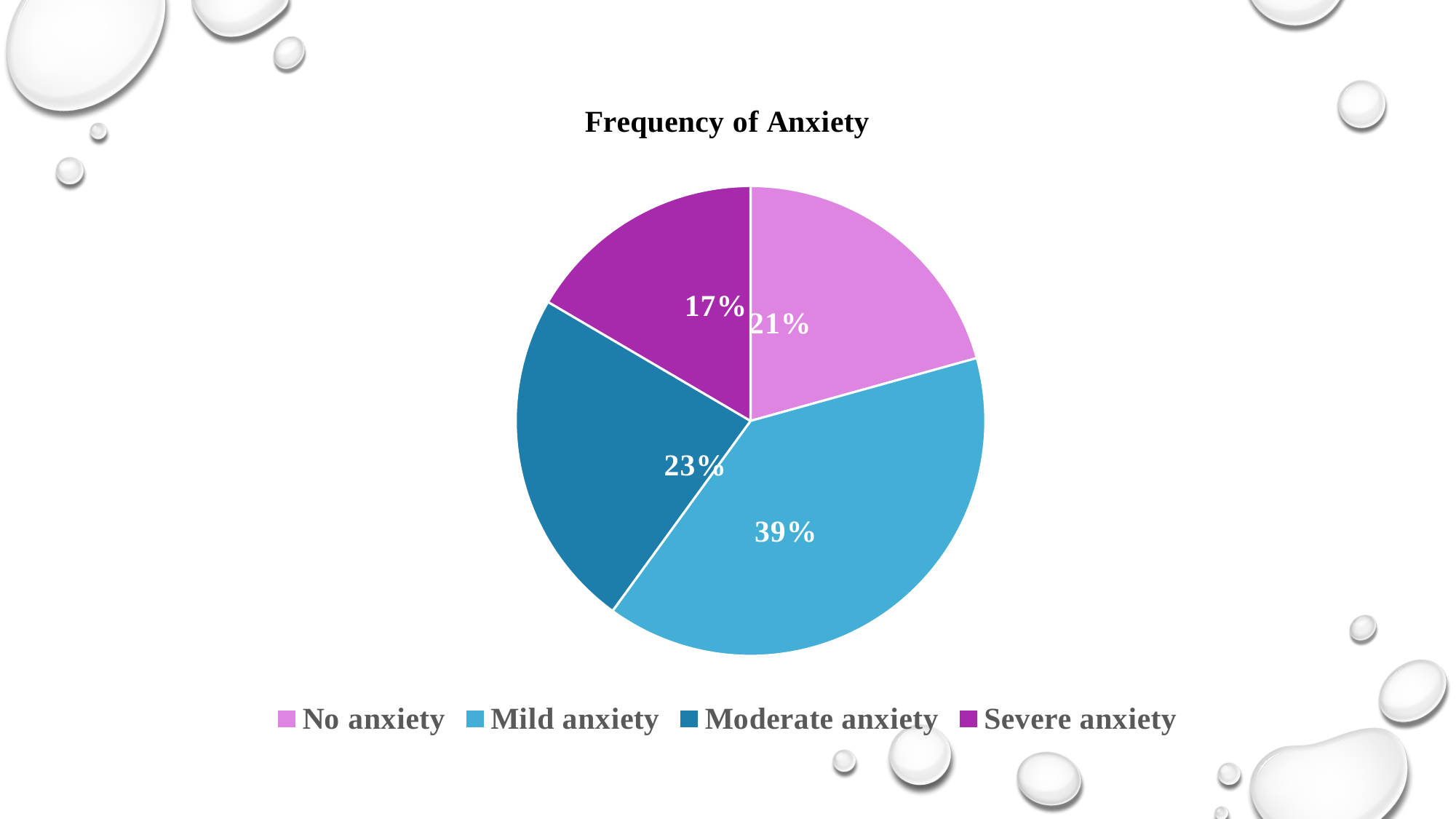
What percentage of the pie is labelled for No anxiety? 21% What is the difference in percentage points between Mild anxiety and Severe anxiety? 22 Which category has the smallest share of the pie? Severe anxiety Which category has the largest share of the pie? Mild anxiety What percentage of the pie is labelled for Mild anxiety? 39% Which is larger, the share for Moderate anxiety or the share for No anxiety? Moderate anxiety How many categories does the legend list? 4 What colour is the Severe anxiety slice? Purple What percentage of the pie is labelled for Severe anxiety? 17% What is the title of the chart? Frequency of Anxiety What percentage of the pie is labelled for Moderate anxiety? 23% What type of chart is shown on the slide? Pie chart